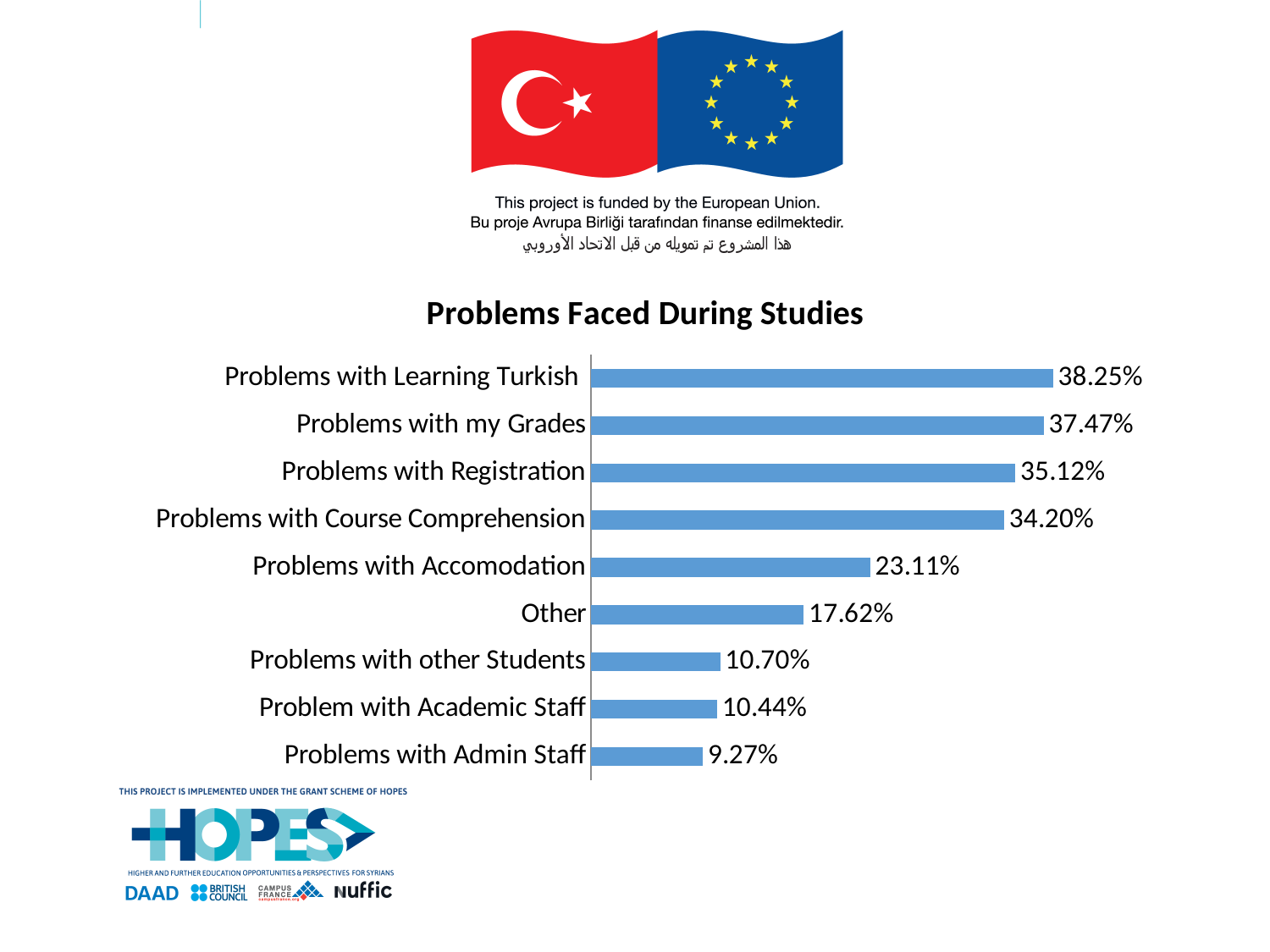
What is the value for Problems with Accomodation? 23.11% Which category has the lowest value? Problems with Admin Staff What is the difference between Problems with Learning Turkish and Problems with Admin Staff? 28.98% What is the difference between Problems with Registration and Problems with Course Comprehension? 0.92% What kind of chart is shown on the slide? Bar chart Which is larger, Problems with my Grades or Problems with Registration? Problems with my Grades What is the value for Other? 17.62% What is the value for Problems with Learning Turkish? 38.25% How many categories are shown in the chart? 9 What is the title of the chart? Problems Faced During Studies Which category has the highest value? Problems with Learning Turkish Which is larger, Problems with Accomodation or Other? Problems with Accomodation